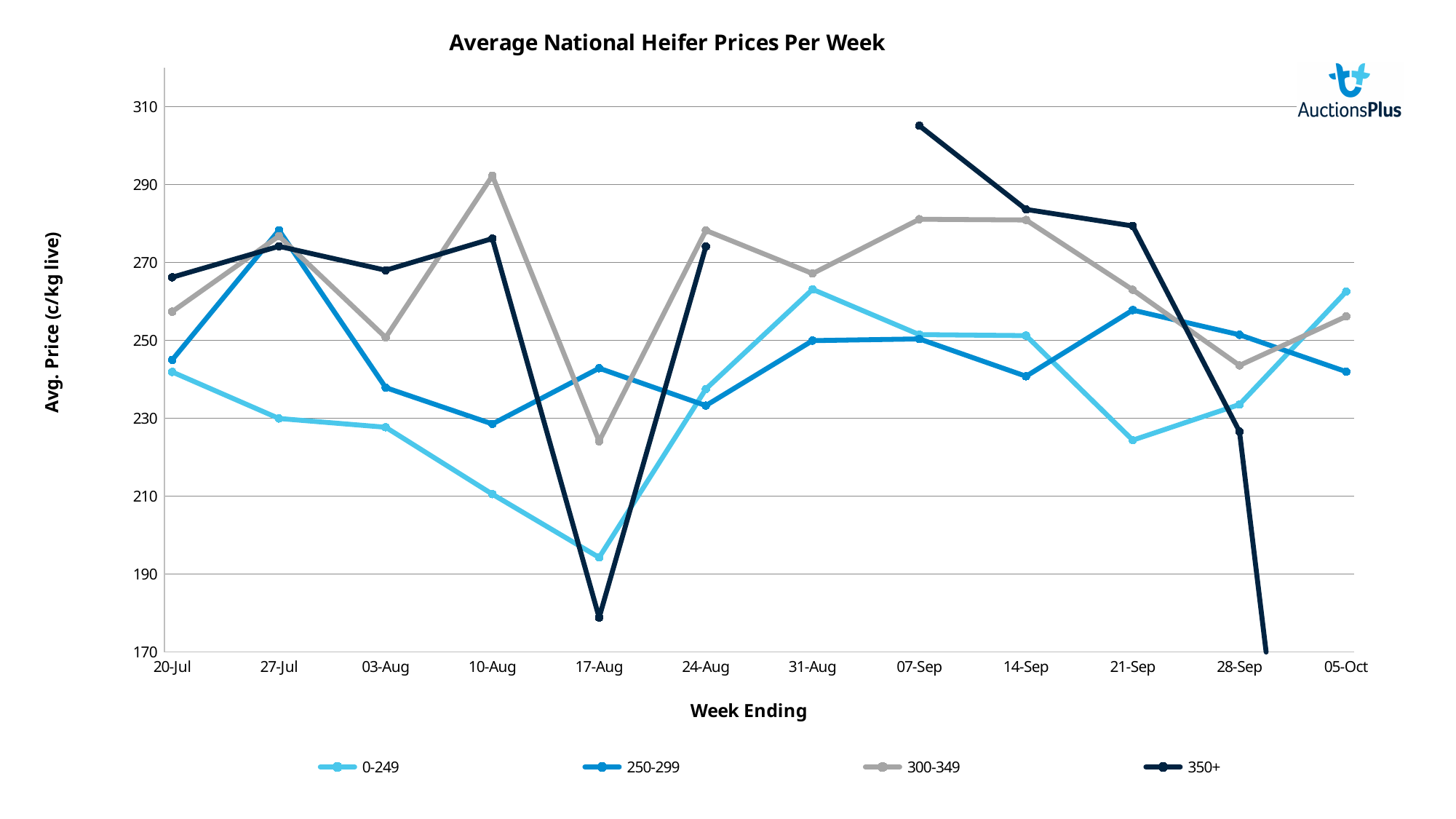
What kind of chart is shown on the slide? line chart In which week does the 0-249 series reach its lowest value? 17-Aug In which week does the 350+ series reach its highest value? 07-Sep Is the value for the 350+ series at 17-Aug greater or less than 190? less Is the value for the 0-249 series at 17-Aug greater or less than 210? less Does the 0-249 series rise or fall from 20-Jul to 17-Aug? fall Is the value for the 300-349 series at 10-Aug greater or less than 270? greater How many series does the legend list? 4 In which week does the 300-349 series reach its highest value? 10-Aug At 10-Aug, which series has the larger value: 300-349 or 0-249? 300-349 What is the title of the y axis? Avg. Price (c/kg live) How many week-ending dates are plotted along the x axis? 12